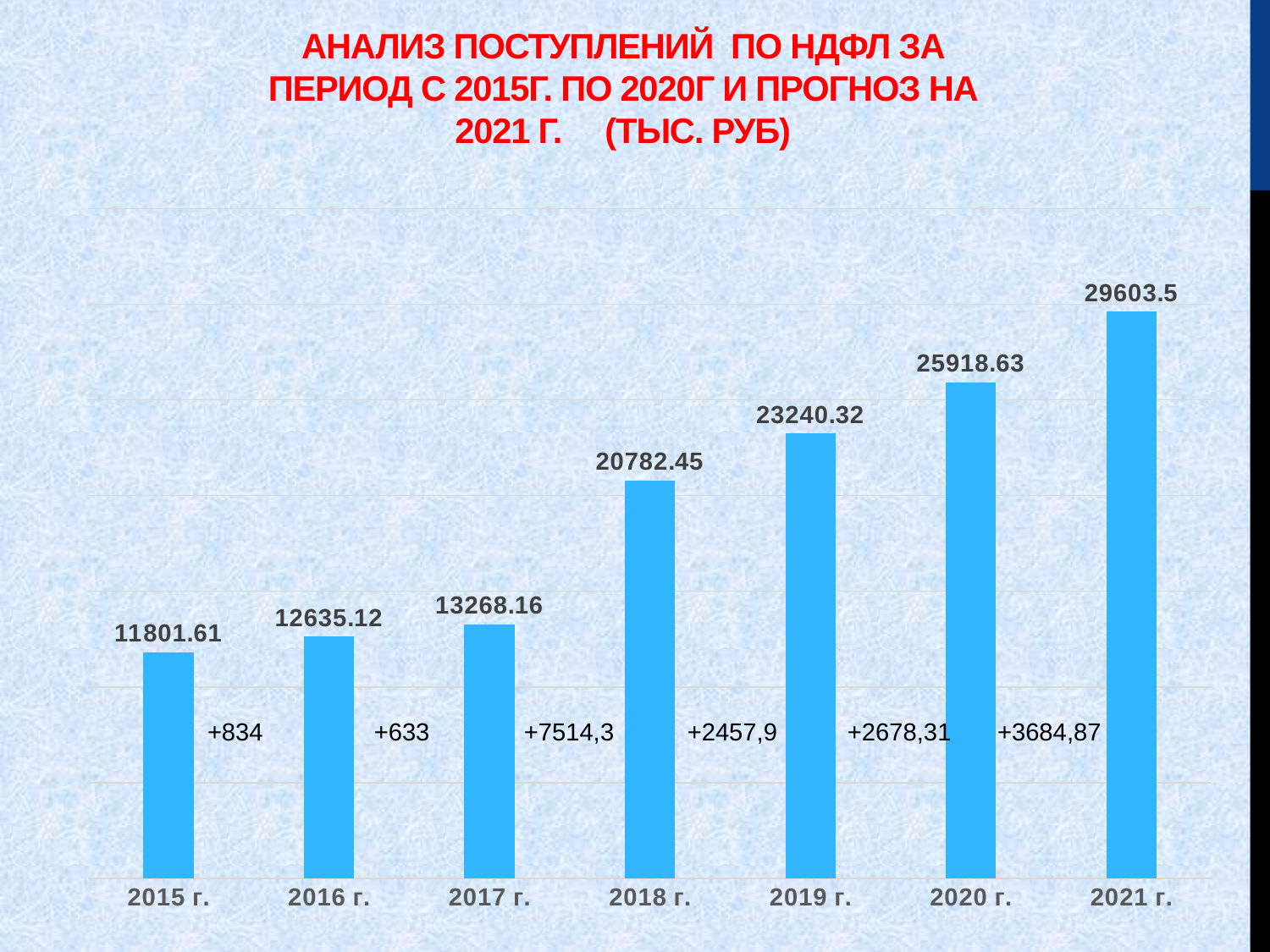
Which year has the highest value? 2021 г. Do the values rise or fall from 2015 г. to 2021 г.? Rise What kind of chart is shown on the slide? Bar chart What is the value for 2019 г.? 23240.32 What is the value for 2018 г.? 20782.45 What is the value for 2015 г.? 11801.61 Which is larger, the value for 2017 г. or the value for 2018 г.? 2018 г. What is the difference between the values for 2020 г. and 2019 г.? 2678.31 What is the value for 2021 г.? 29603.5 Which year has the lowest value? 2015 г. How many years (bars) are shown in the chart? 7 What is the difference between the values for 2021 г. and 2020 г.? 3684.87